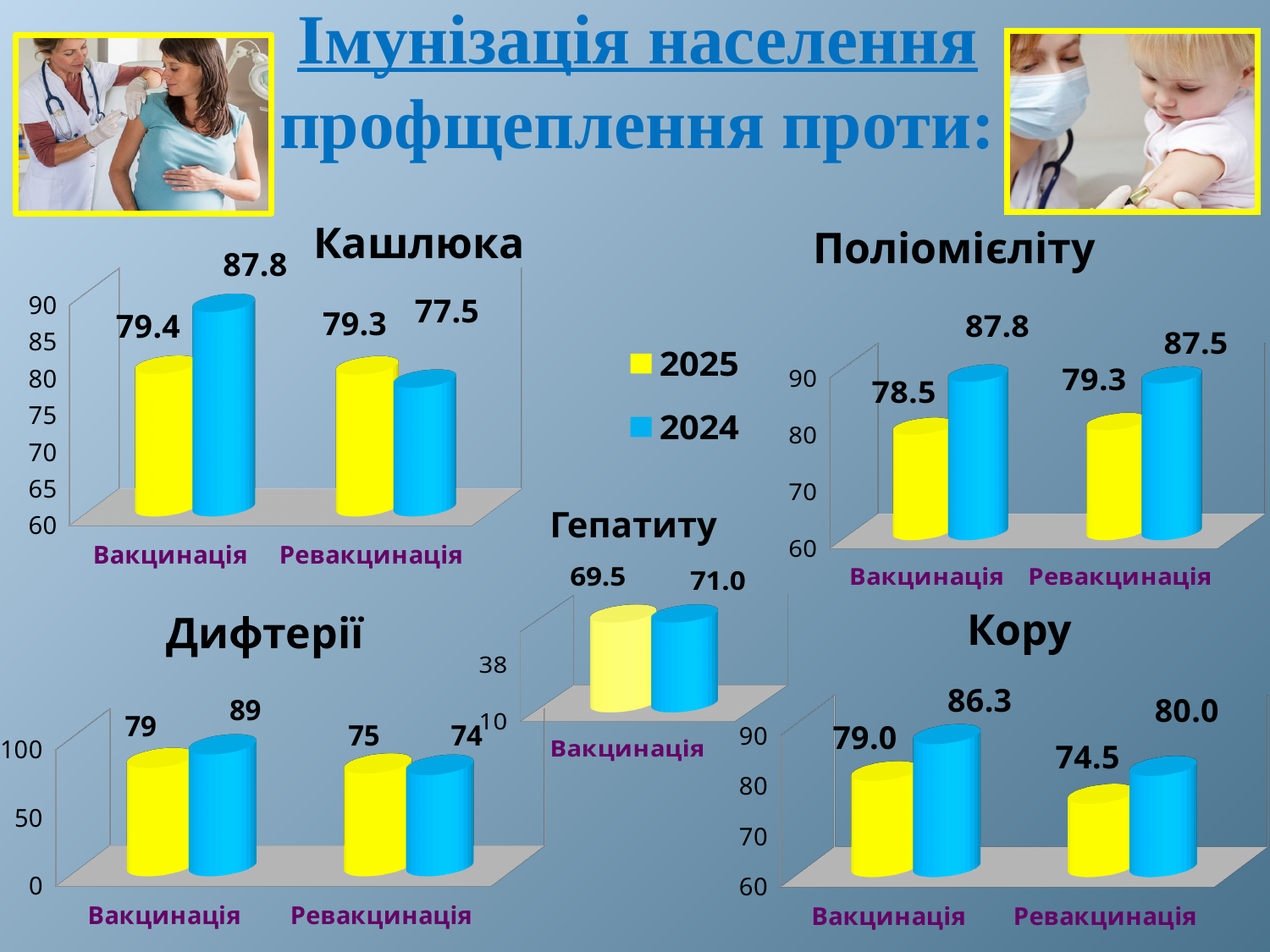
In the "Дифтерії" chart, what is the 2024 value for Вакцинація? 89 In the "Кору" chart, which bar is the highest? Вакцинація 2024 (86.3) In the "Гепатиту" chart, what is the 2024 value for Вакцинація? 71.0 In the "Кашлюка" chart, what is the 2024 value for Вакцинація? 87.8 What type of chart is the "Дифтерії" chart? Bar chart In the "Поліомієліту" chart, which is larger for Ревакцинація: the 2025 value or the 2024 value? 2024 How many series does the legend list? 2 In the "Дифтерії" chart, what is the difference between the 2024 and 2025 values for Вакцинація? 10 In the "Поліомієліту" chart, what is the 2025 value for Вакцинація? 78.5 In the "Кору" chart, what is the 2025 value for Ревакцинація? 74.5 In the "Кору" chart, is the 2025 value for Ревакцинація greater or less than 80? less In the "Кашлюка" chart, what is the difference between the 2025 and 2024 values for Ревакцинація? 1.8